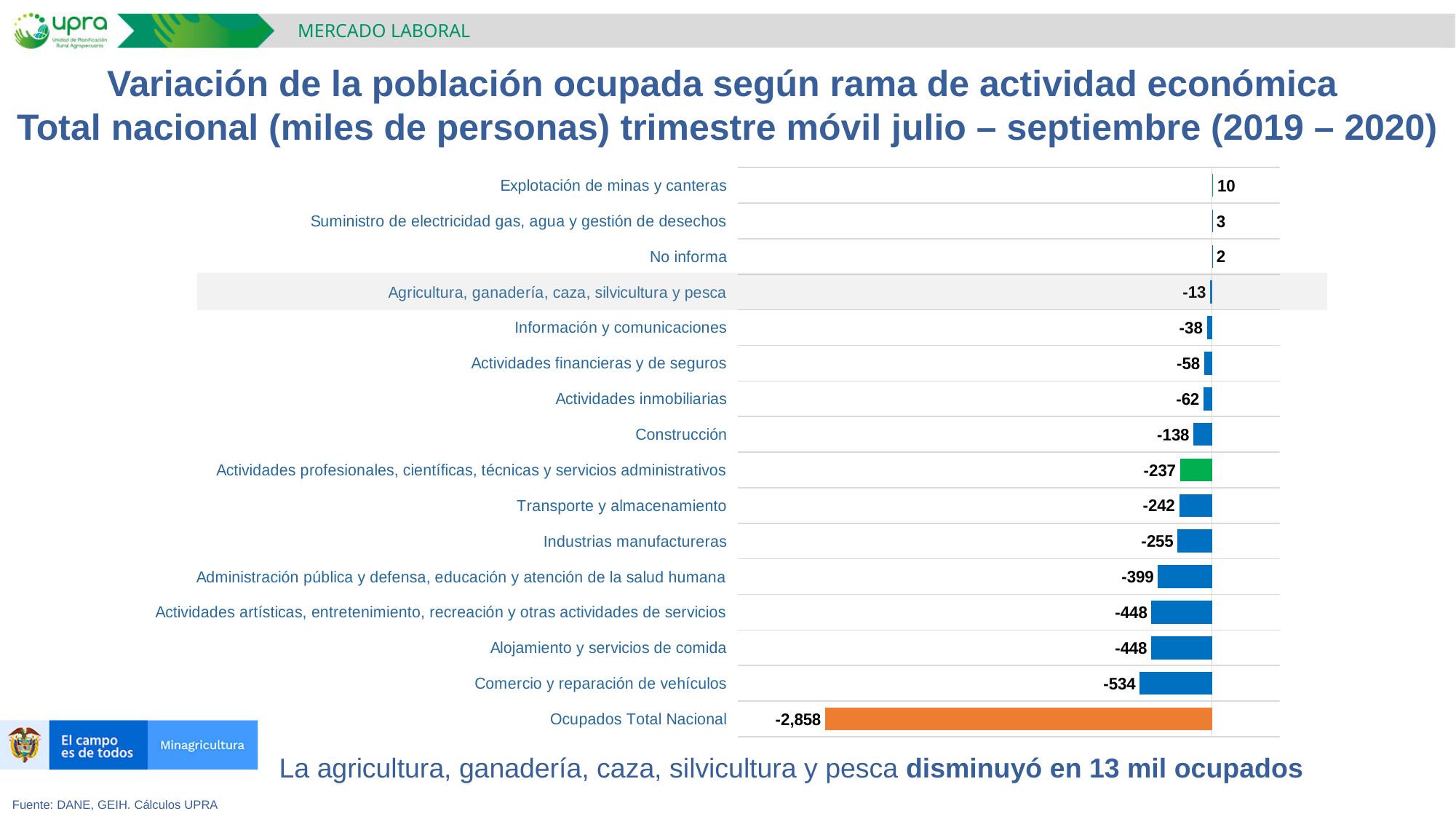
Which is larger, the value for Transporte y almacenamiento or the value for Industrias manufactureras? Transporte y almacenamiento What is the value for Agricultura, ganadería, caza, silvicultura y pesca? -13 What is the value for Comercio y reparación de vehículos? -534 Which category's bar is coloured green? Actividades profesionales, científicas, técnicas y servicios administrativos and Explotación de minas y canteras What kind of chart is shown on the slide? Bar chart How many categories are shown in the chart? 16 Which category has the lowest value? Ocupados Total Nacional Which category has the highest value? Explotación de minas y canteras What is the difference between the values for Comercio y reparación de vehículos and Construcción? 396 Which category's bar is coloured orange? Ocupados Total Nacional What is the value for Explotación de minas y canteras? 10 What is the value for Ocupados Total Nacional? -2,858